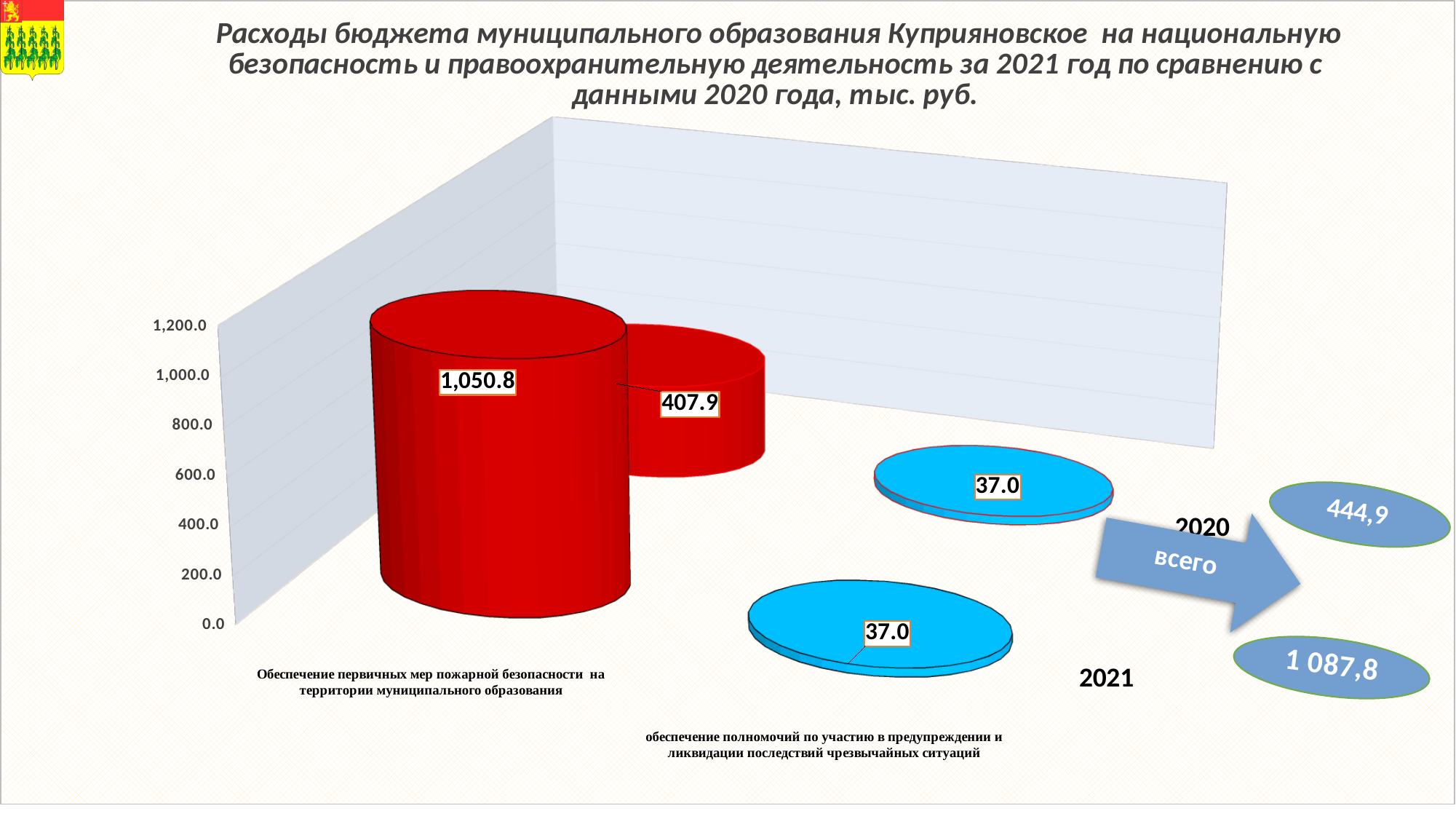
What is the value for 'Обеспечение первичных мер пожарной безопасности на территории муниципального образования' in 2020? 407.9 Which category has the highest value in 2021? Обеспечение первичных мер пожарной безопасности на территории муниципального образования What is the value for 'обеспечение полномочий по участию в предупреждении и ликвидации последствий чрезвычайных ситуаций' in 2021? 37.0 Which category has the lowest value in 2020? обеспечение полномочий по участию в предупреждении и ликвидации последствий чрезвычайных ситуаций Which is larger: the 2021 value or the 2020 value for 'Обеспечение первичных мер пожарной безопасности'? 2021 What type of chart is shown on the slide? bar chart What is the value for 'обеспечение полномочий по участию в предупреждении и ликвидации последствий чрезвычайных ситуаций' in 2020? 37.0 By how much did spending on 'Обеспечение первичных мер пожарной безопасности' change from 2020 to 2021? 642.9 How many expenditure categories are shown in the chart? 2 What is the value for 'Обеспечение первичных мер пожарной безопасности на территории муниципального образования' in 2021? 1,050.8 What is the total ('всего') shown for 2021? 1 087,8 Is the 2021 value for 'Обеспечение первичных мер пожарной безопасности' greater or less than 1,000.0? greater